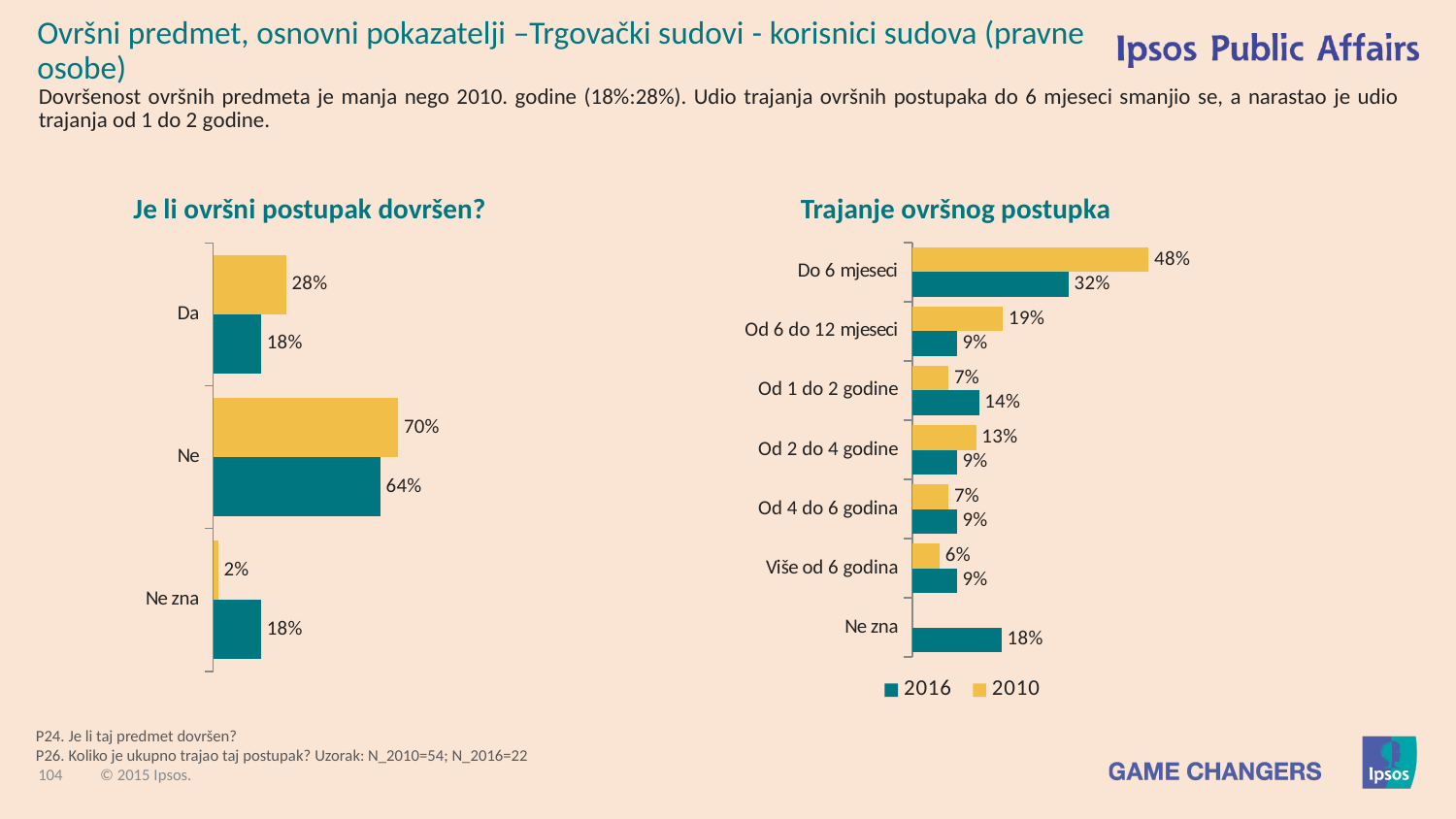
In the chart 'Trajanje ovršnog postupka', what is the 2016 value for 'Od 1 do 2 godine'? 14% In the chart 'Trajanje ovršnog postupka', which category has the highest 2016 value? Do 6 mjeseci In the chart 'Je li ovršni postupak dovršen?', what is the value of the yellow (2010) bar for 'Ne'? 70% In the chart 'Trajanje ovršnog postupka', what is the 2010 value for 'Do 6 mjeseci'? 48% In the chart 'Trajanje ovršnog postupka', what is the difference between the 2010 and 2016 values for 'Do 6 mjeseci'? 16% In the chart 'Je li ovršni postupak dovršen?', what is the difference between the 2010 and 2016 values for 'Da'? 10% In the chart 'Trajanje ovršnog postupka', which category has the lowest 2010 value? Više od 6 godina How many categories are shown in the chart 'Trajanje ovršnog postupka'? 7 What type of chart is 'Je li ovršni postupak dovršen?'? Bar chart In the chart 'Trajanje ovršnog postupka', which is larger for 'Od 6 do 12 mjeseci': the 2016 value or the 2010 value? 2010 In the chart 'Je li ovršni postupak dovršen?', what is the value of the teal (2016) bar for 'Ne zna'? 18% How many series does the legend of the chart 'Trajanje ovršnog postupka' list? 2